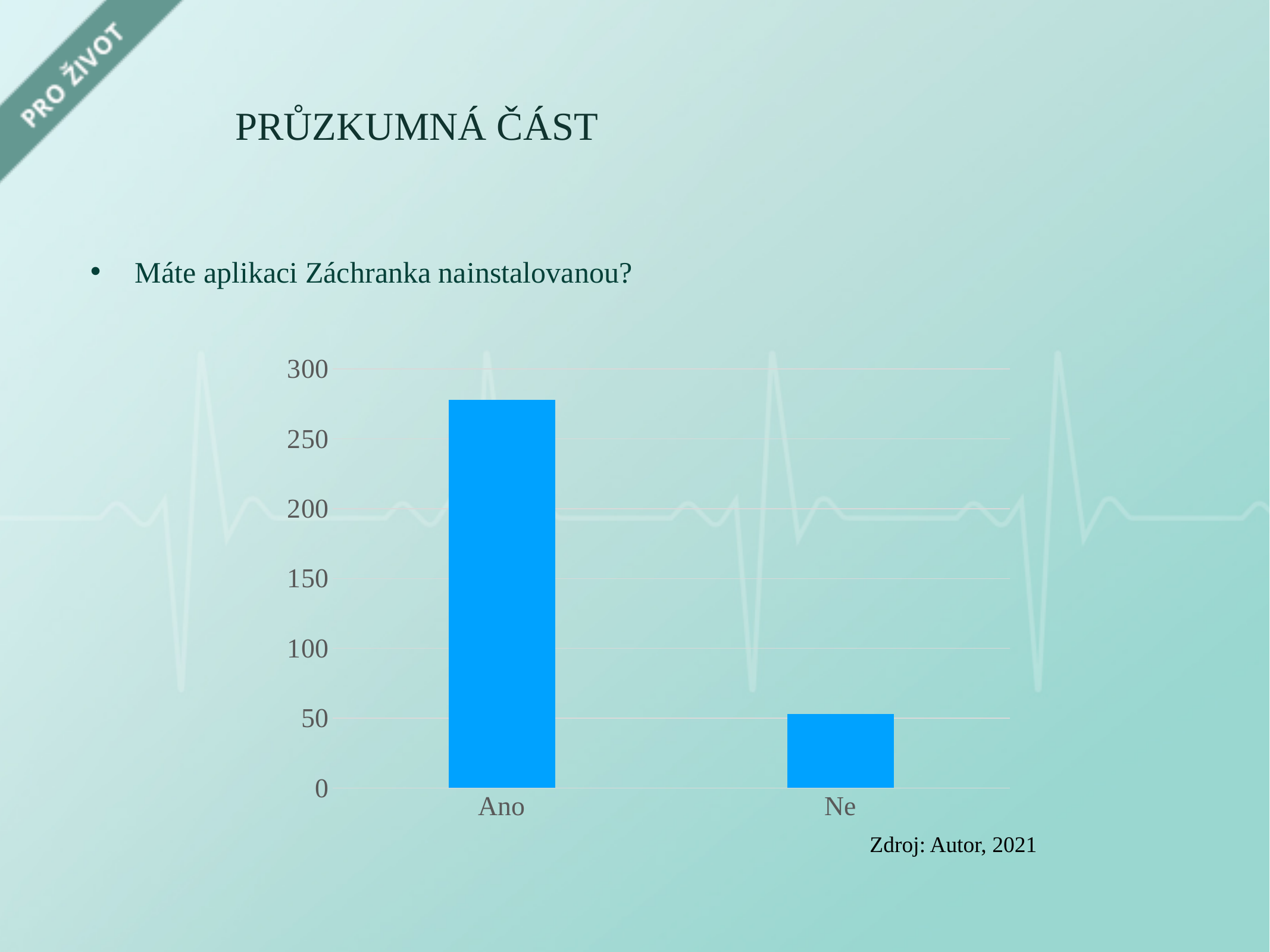
How many categories are shown on the x axis of the chart? 2 Which category has the highest value in the chart? Ano What kind of chart is shown on the slide? bar chart What is the highest tick value shown on the vertical axis of the chart? 300 What survey question does the chart on the slide relate to? Máte aplikaci Záchranka nainstalovanou? Is the value for Ano greater or less than 300? less Is the value for Ano greater or less than 250? greater Is the value for Ne greater or less than 100? less Which category has the lowest value in the chart? Ne Which is larger, the value for Ano or the value for Ne? Ano